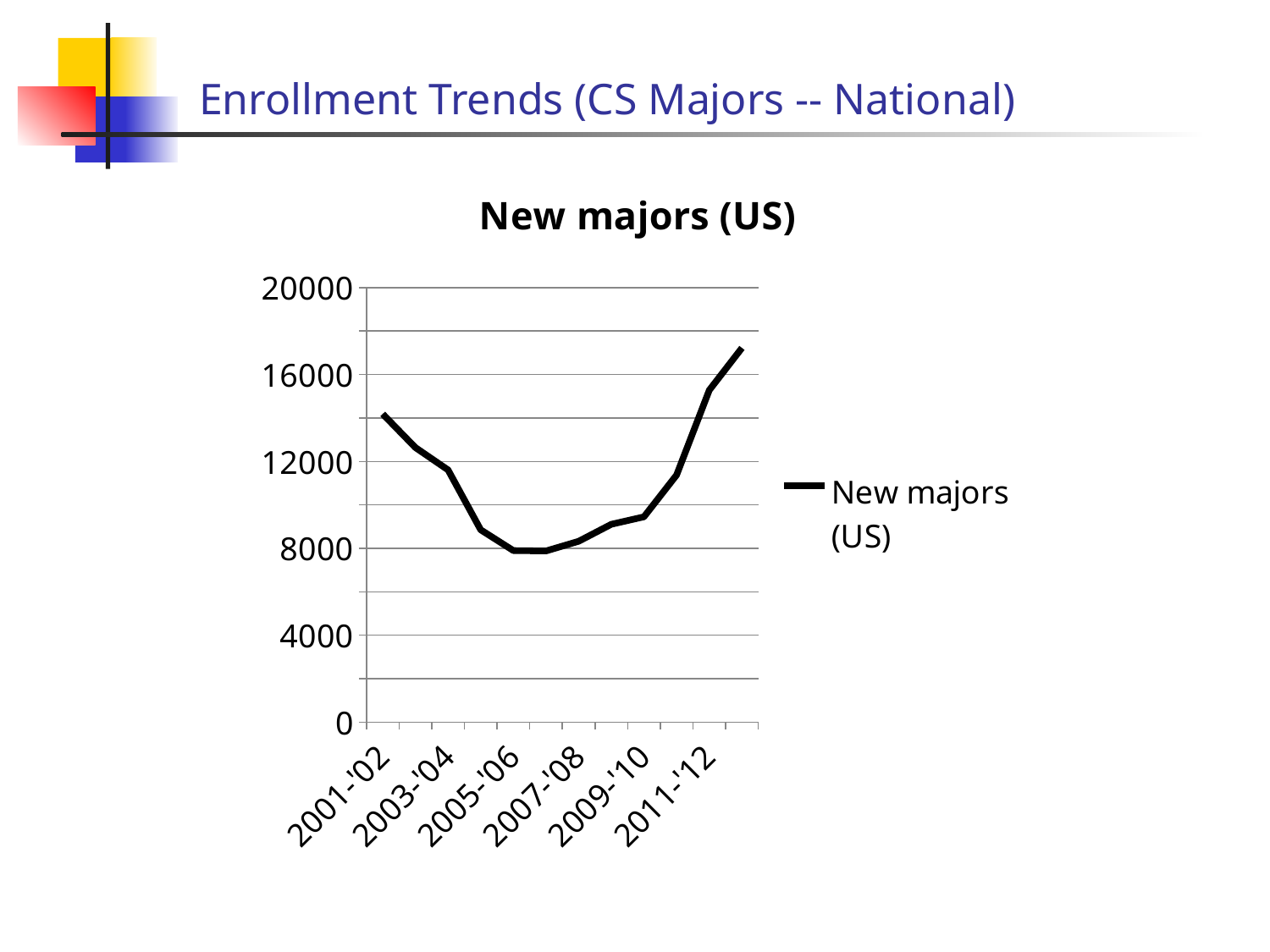
Is the value for 2009-'10 greater or less than 12000? less Which of the labeled years has the highest value? 2011-'12 Which is larger, the value for 2001-'02 or the value for 2009-'10? 2001-'02 Is the value for 2011-'12 greater or less than 12000? greater Do the values rise or fall from 2001-'02 to 2007-'08? fall What is the title of the chart? New majors (US) What kind of chart is shown on the slide? line chart How many series does the legend list? 1 Which of the labeled years has the lowest value? 2005-'06 Is the value for 2001-'02 greater or less than 12000? greater What is the name of the series shown in the legend? New majors (US)